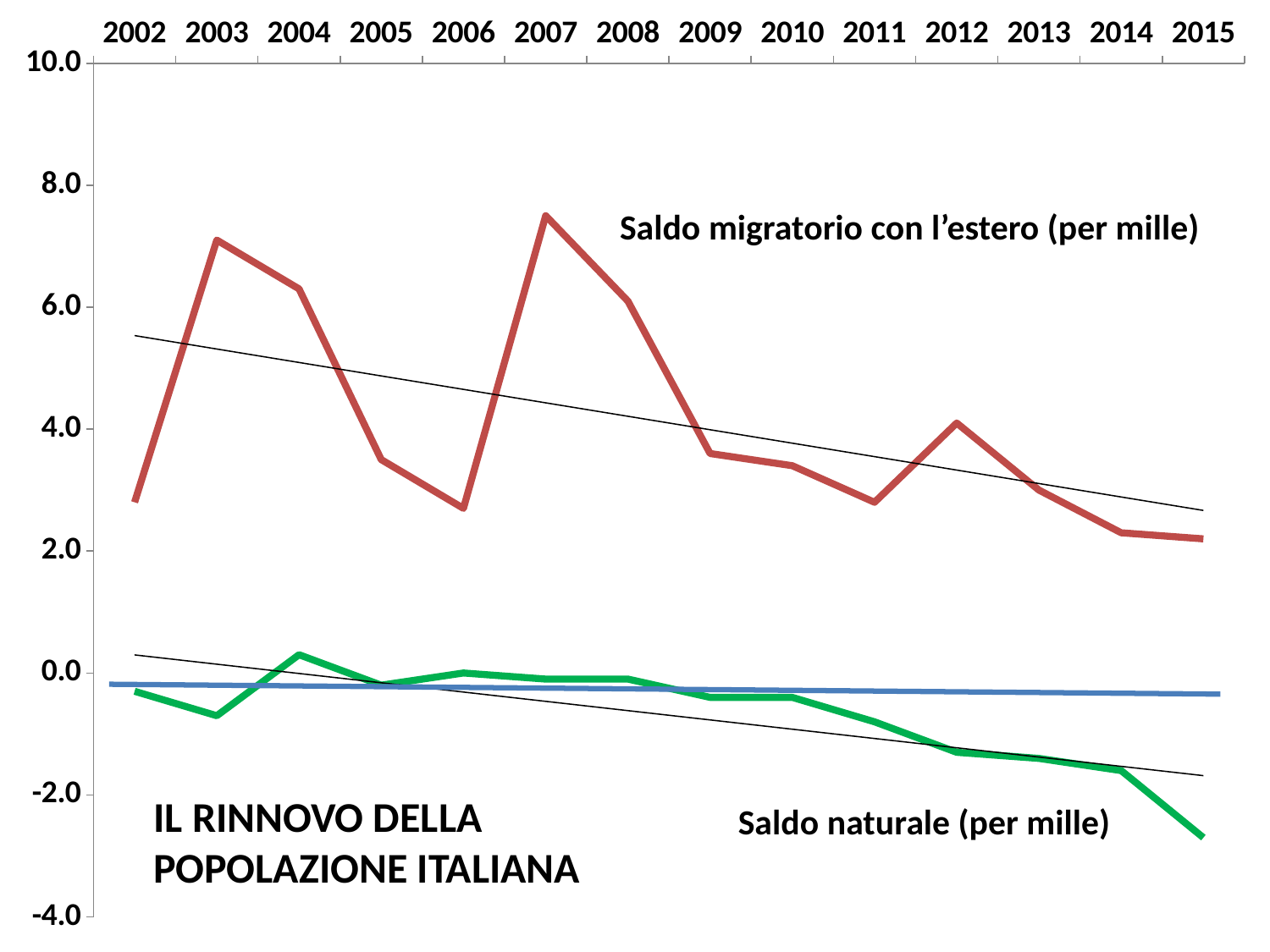
Is the value of 'Saldo migratorio con l'estero (per mille)' in 2007 greater or less than 6.0? greater Is the value of 'Saldo naturale (per mille)' in 2015 greater or less than -2.0? less What colour is the line for 'Saldo naturale (per mille)'? green How many years are shown along the x axis? 14 What kind of chart is shown on the slide? line chart Which year has the larger value for 'Saldo migratorio con l'estero (per mille)', 2003 or 2004? 2003 Is the value of 'Saldo migratorio con l'estero (per mille)' in 2005 greater or less than 4.0? less In which year does the 'Saldo naturale (per mille)' series reach its lowest value? 2015 In which year does the 'Saldo naturale (per mille)' series reach its highest value? 2004 Which year has the larger value for 'Saldo naturale (per mille)', 2011 or 2013? 2011 Does the 'Saldo naturale (per mille)' series rise or fall from 2010 to 2015? fall In which year does the 'Saldo migratorio con l'estero (per mille)' series reach its highest value? 2007